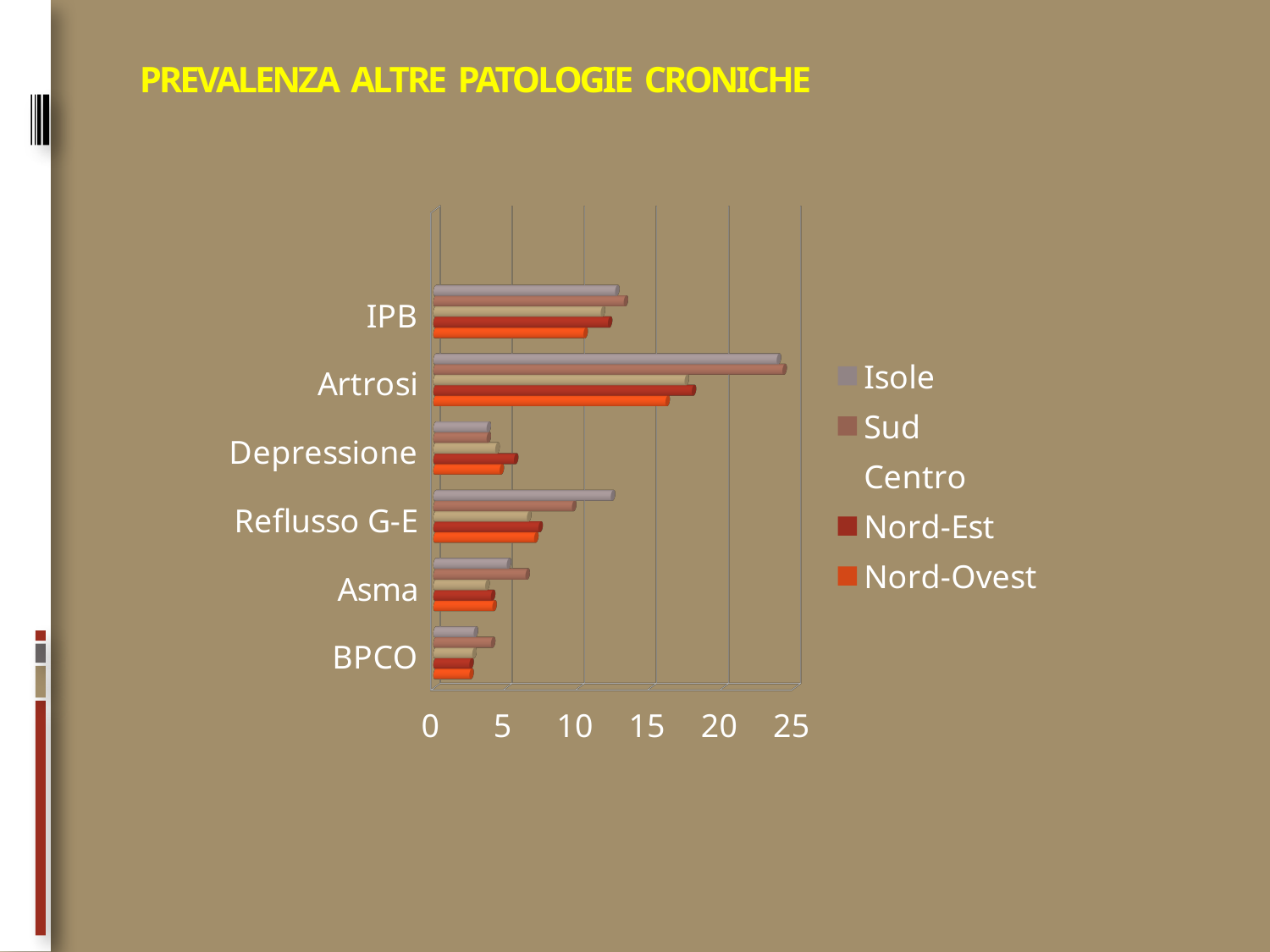
Is the value for Artrosi in the Isole series greater or less than 20? greater Is the value for Artrosi in the Nord-Est series greater or less than 15? greater For Artrosi, which series has the larger value: Sud or Nord-Ovest? Sud Is the value for Reflusso G-E in the Isole series greater or less than 10? greater Which category has the lowest values across the series? BPCO What kind of chart is shown on the slide? bar chart Which category has the highest values across the series? Artrosi What is the title of the slide? PREVALENZA ALTRE PATOLOGIE CRONICHE How many series does the legend list? 5 How many disease categories are shown on the chart? 6 For the Isole series, which is larger: Artrosi or IPB? Artrosi